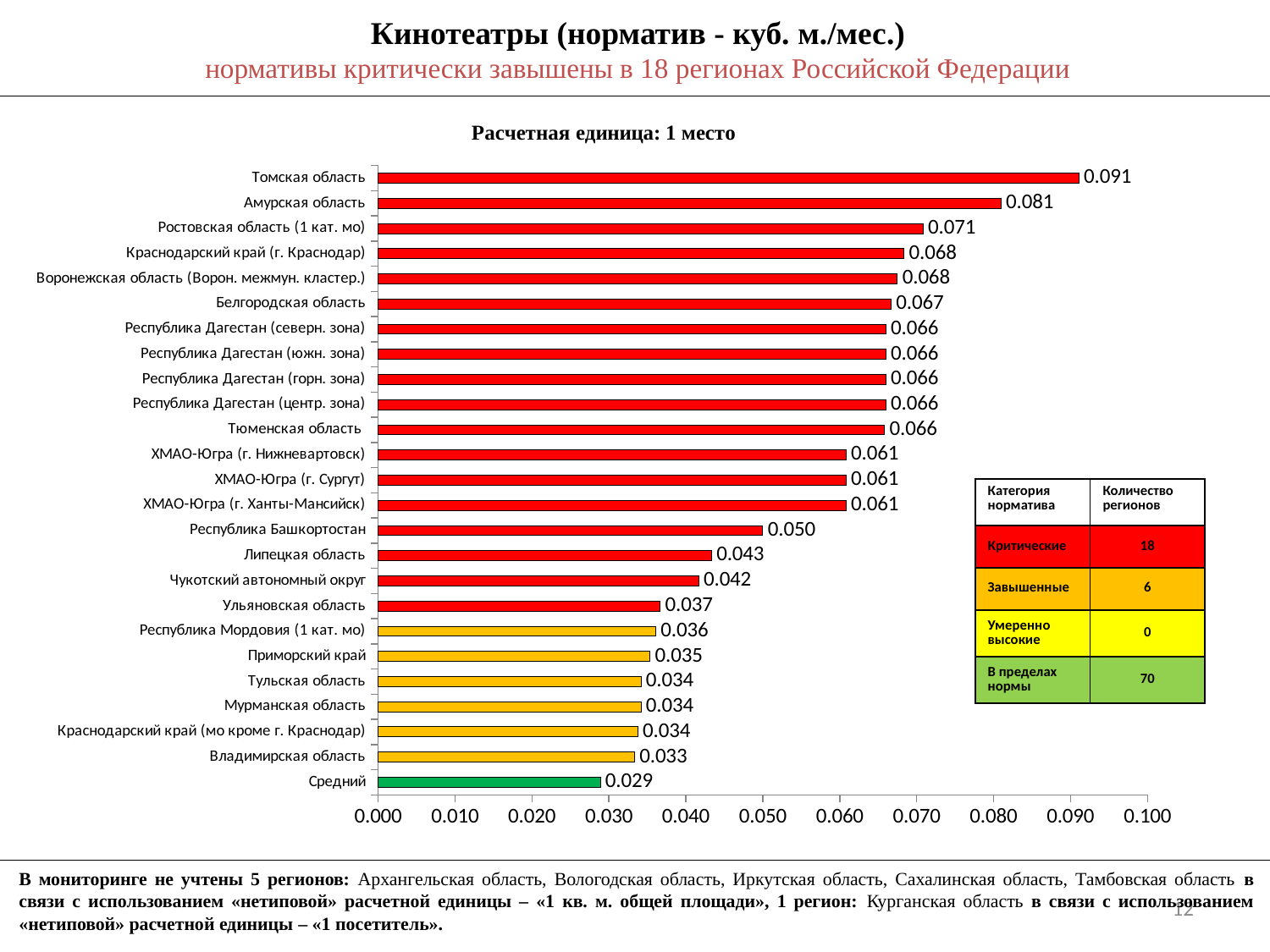
Which category has the lowest value? Средний What is the difference between the values for Липецкая область and Средний? 0.014 What is the difference between the values for Томская область and Амурская область? 0.010 What is the value for Средний? 0.029 What kind of chart is shown on the slide? bar chart What is the value for Республика Башкортостан? 0.050 Which is larger, the value for Чукотский автономный округ or the value for Ульяновская область? Чукотский автономный округ Is the value for Ростовская область (1 кат. мо) greater or less than 0.060? greater Which category has the highest value? Томская область How many bars are plotted in the chart? 25 What is the title of the chart? Расчетная единица: 1 место What is the value for Томская область? 0.091